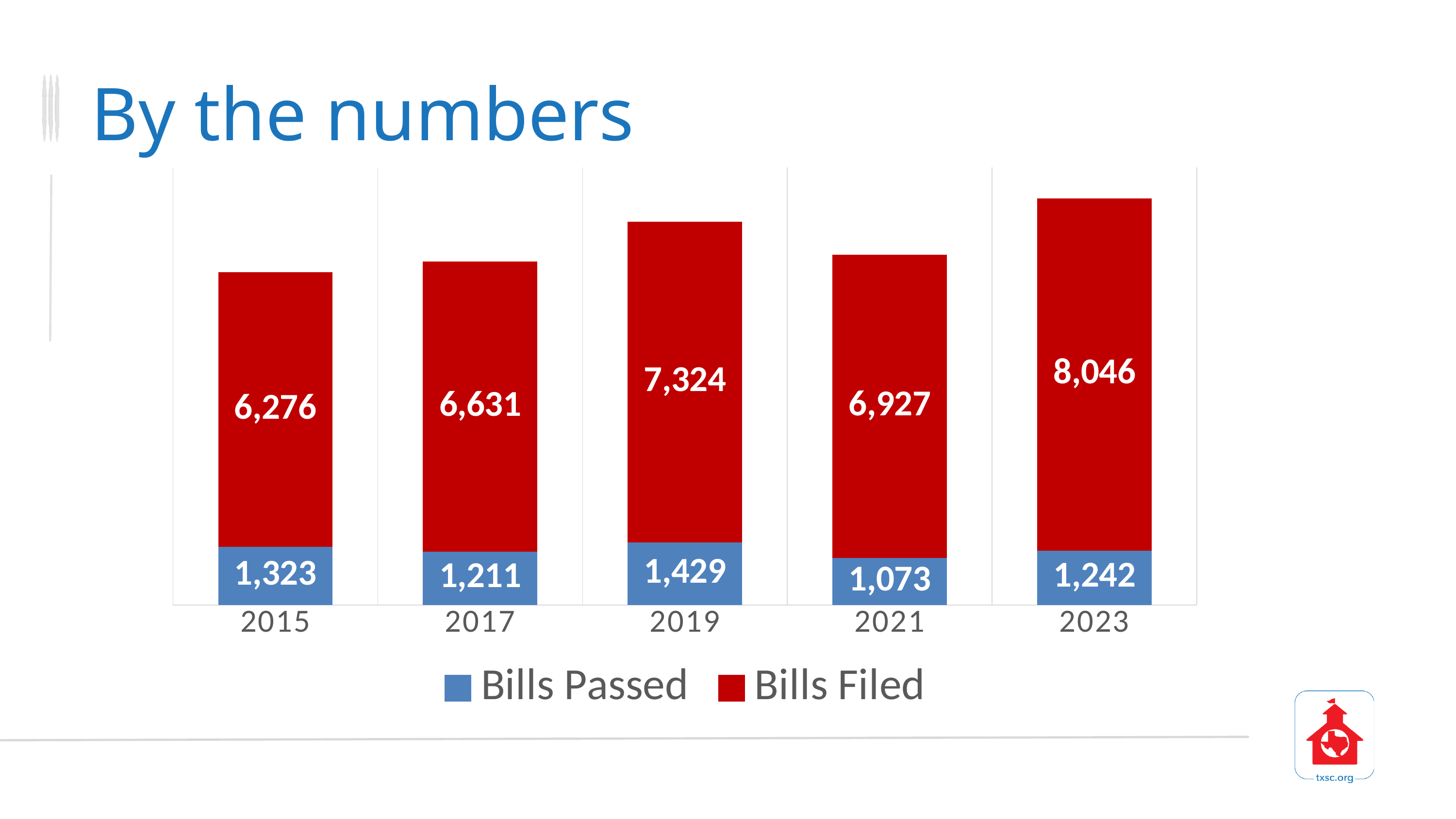
What is the value of Bills Filed for 2019? 7,324 What kind of chart is shown on the slide? Stacked bar chart What is the value of Bills Passed for 2021? 1,073 Which year has the highest value for Bills Filed? 2023 What is the difference between Bills Filed in 2023 and Bills Filed in 2015? 1,770 What is the difference between Bills Passed in 2019 and Bills Passed in 2021? 356 Which year has the lowest value for Bills Passed? 2021 How many series does the legend list? 2 How many years are shown on the x axis? 5 Which is larger: Bills Filed in 2017 or Bills Filed in 2021? Bills Filed in 2021 What is the total of the stacked bar for 2023 (Bills Passed plus Bills Filed)? 9,288 Which colour represents Bills Passed in the legend? Blue